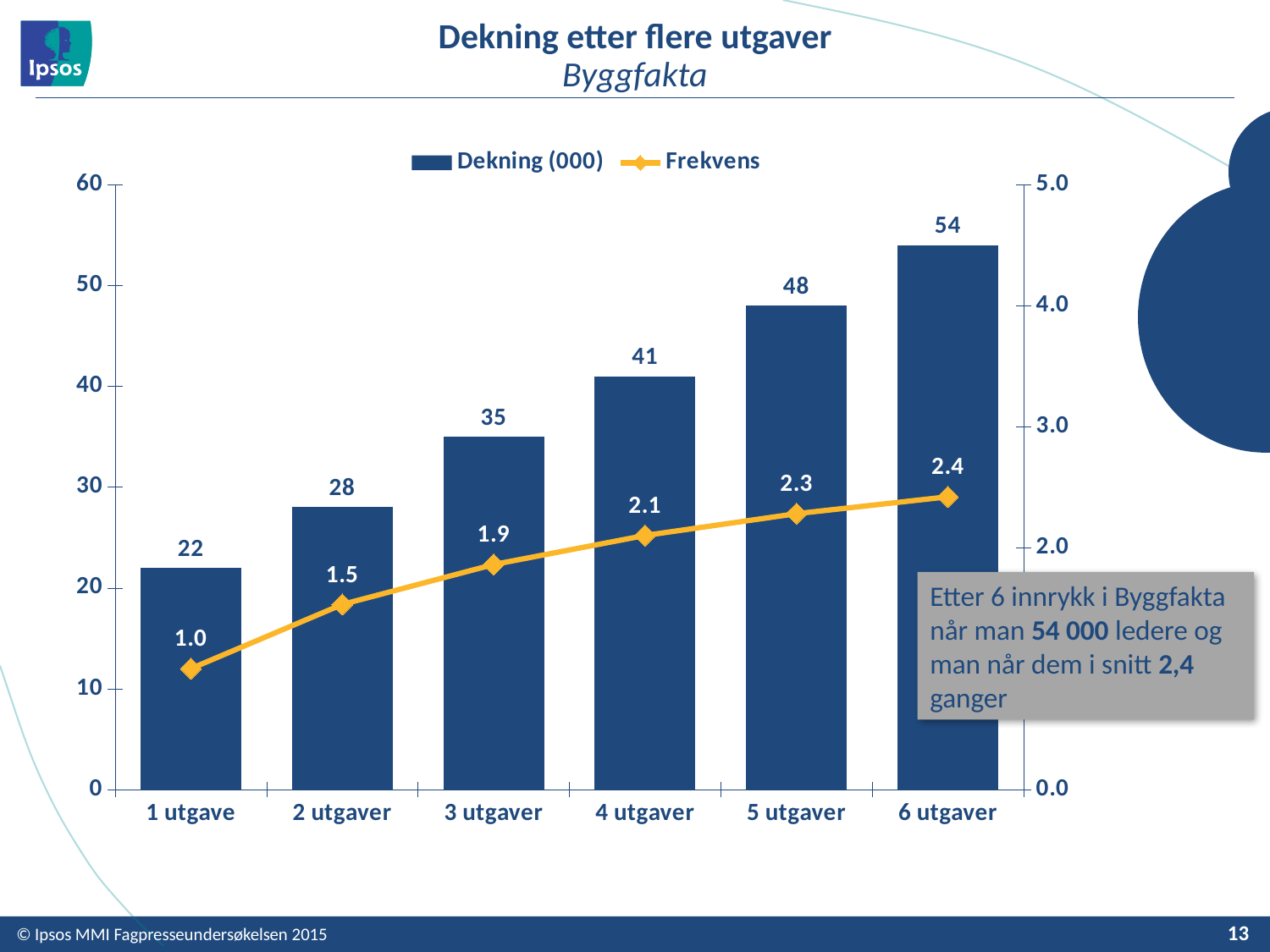
Which category has the highest Frekvens value? 6 utgaver How many categories are shown on the x axis? 6 What is the Dekning (000) value for 6 utgaver? 54 How many series does the legend list? 2 Do the Frekvens values rise or fall from 1 utgave to 6 utgaver? rise What is the Frekvens value for 4 utgaver? 2.1 What is the difference in Dekning (000) between 5 utgaver and 2 utgaver? 20 Which category has the lowest Dekning (000) value? 1 utgave Which is larger, the Dekning (000) value for 4 utgaver or for 3 utgaver? 4 utgaver What is the subtitle of the chart shown under 'Dekning etter flere utgaver'? Byggfakta What kind of chart is used to show the Dekning (000) series? bar chart What is the Dekning (000) value for 3 utgaver? 35